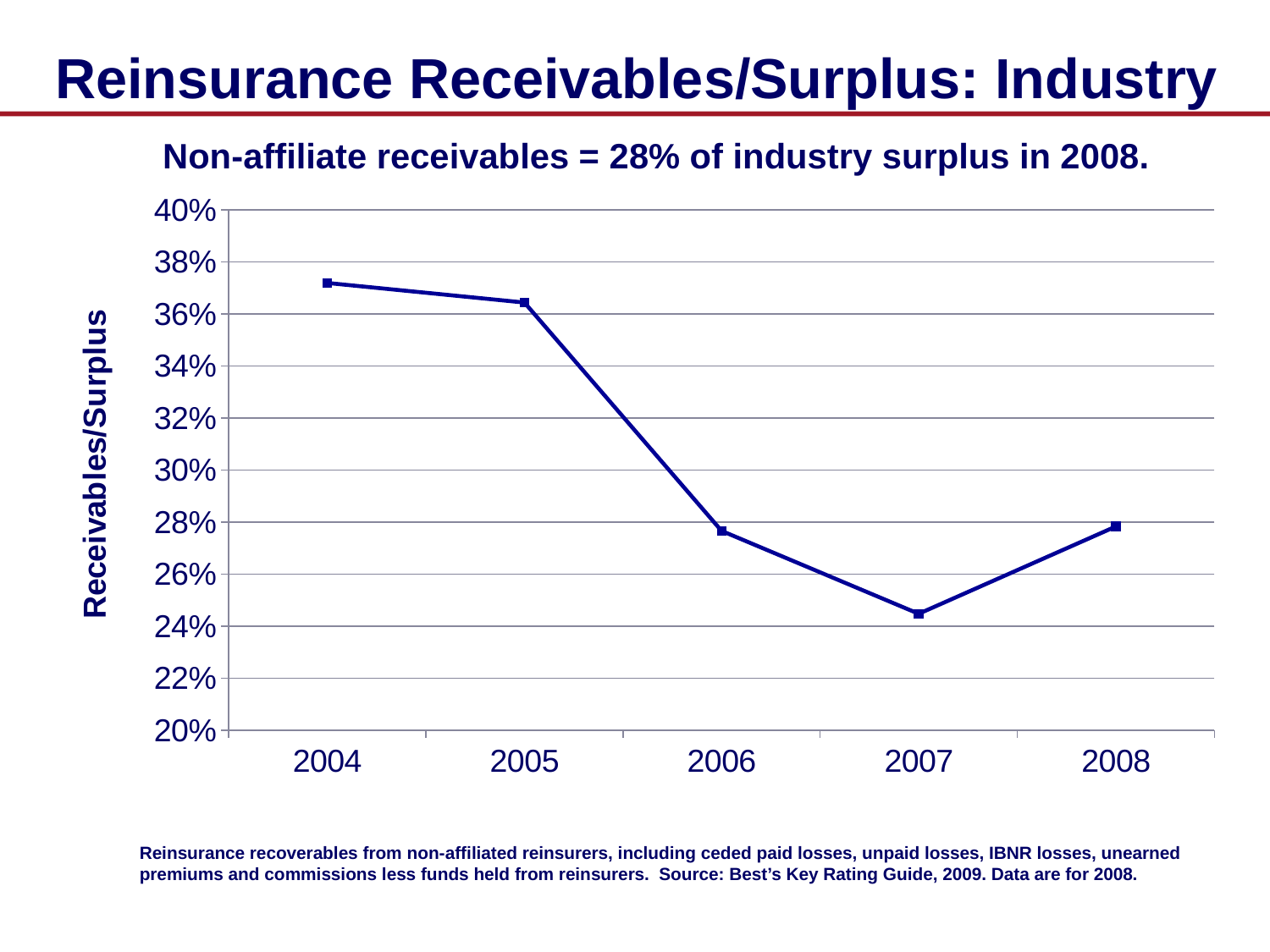
Which is larger, the value for 2005 or the value for 2006? 2005 What kind of chart is shown on the slide? line chart Which year has the lowest Receivables/Surplus value? 2007 Do the values rise or fall from 2004 to 2007? fall Is the value for 2006 greater or less than 30%? less Is the value for 2007 greater or less than 26%? less What is the title of the y axis of the chart? Receivables/Surplus How many years are plotted on the x axis of the chart? 5 Which is larger, the value for 2004 or the value for 2007? 2004 Which year has the highest Receivables/Surplus value? 2004 Is the value for 2005 greater or less than 34%? greater